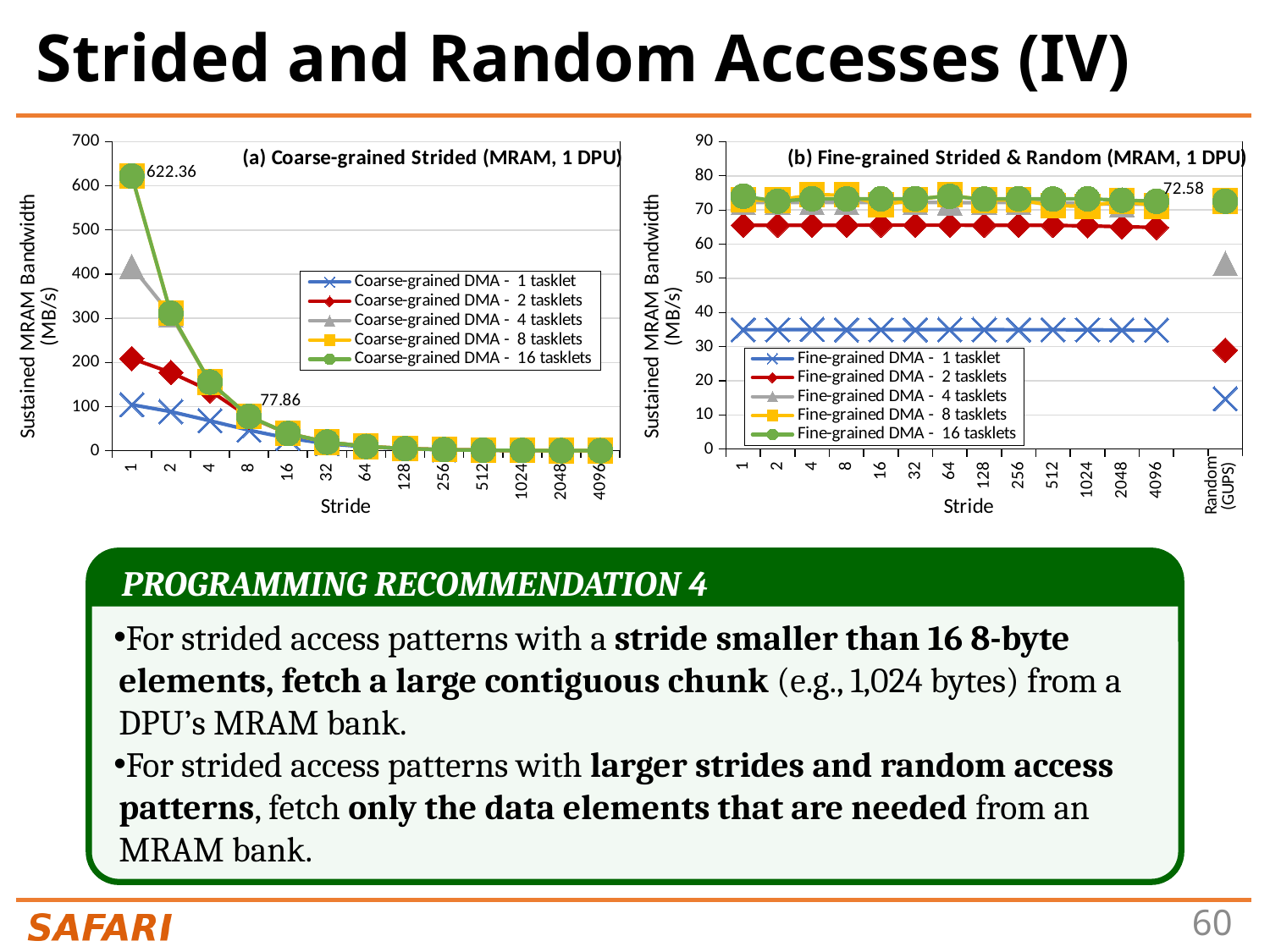
How many series does the legend of chart (b) Fine-grained Strided & Random (MRAM, 1 DPU) list? 5 In chart (a) Coarse-grained Strided, what is the labelled value of the Coarse-grained DMA - 16 tasklets series at stride 1? 622.36 In chart (b) Fine-grained Strided & Random, what is the labelled value of the Fine-grained DMA - 16 tasklets series at stride 4096? 72.58 What is the y-axis label of chart (a) Coarse-grained Strided? Sustained MRAM Bandwidth (MB/s) What kind of chart is chart (a) Coarse-grained Strided (MRAM, 1 DPU)? Line chart How many categories are shown on the x axis of chart (b) Fine-grained Strided & Random, including Random (GUPS)? 14 How many stride categories are shown on the x axis of chart (a) Coarse-grained Strided? 13 In chart (b) Fine-grained Strided & Random, at Random (GUPS), which is larger: Fine-grained DMA - 4 tasklets or Fine-grained DMA - 2 tasklets? Fine-grained DMA - 4 tasklets In chart (b) Fine-grained Strided & Random, is the value for Fine-grained DMA - 1 tasklet at stride 1 greater or less than 40? less In chart (b) Fine-grained Strided & Random, is the value for Fine-grained DMA - 1 tasklet at Random (GUPS) greater or less than 20? less In chart (a) Coarse-grained Strided, at which stride does the Coarse-grained DMA - 16 tasklets series reach its highest bandwidth? 1 In chart (a) Coarse-grained Strided, do the bandwidth values rise or fall as the stride increases? Fall